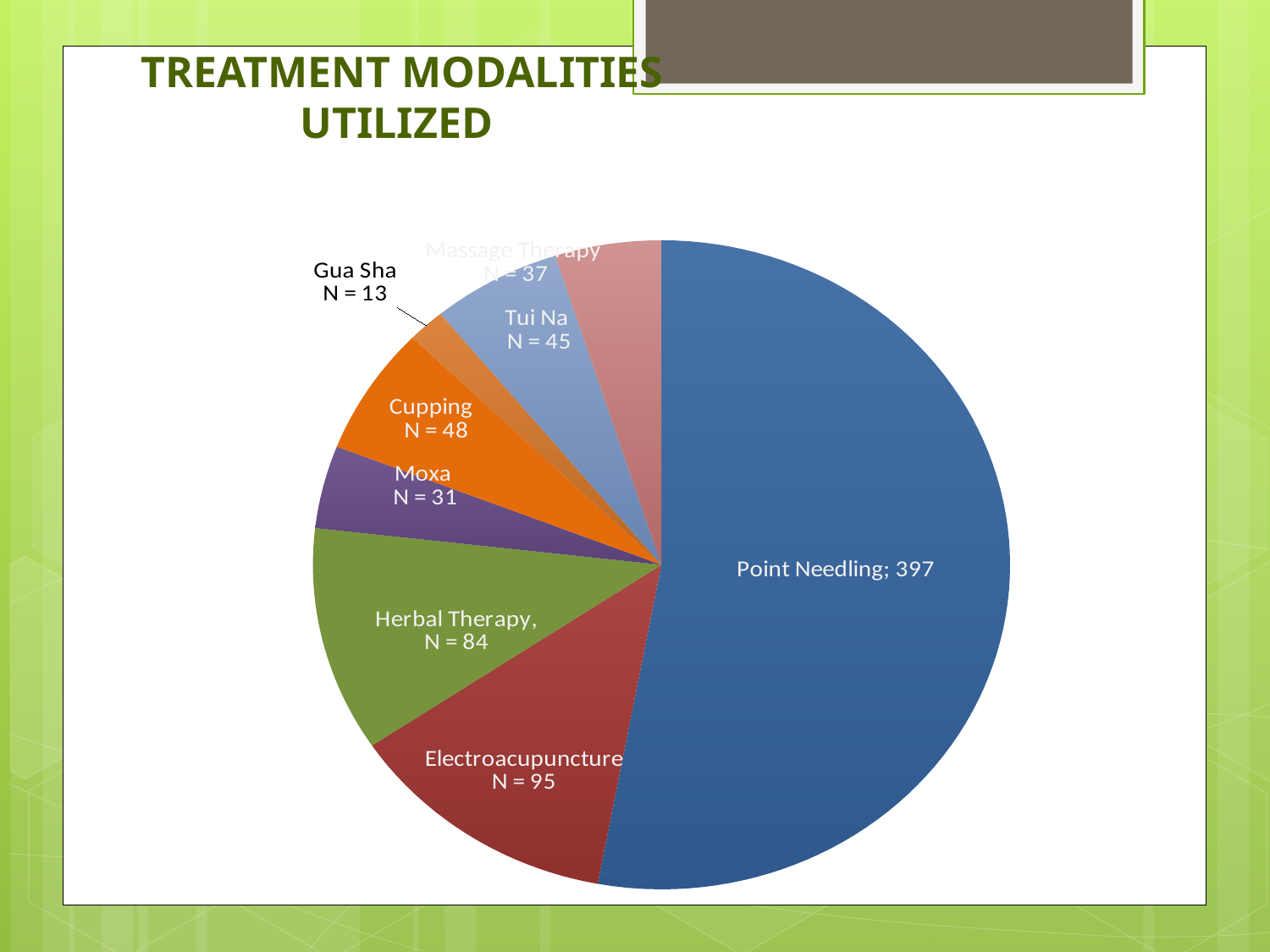
What is the N value for Cupping? 48 What type of chart is shown on the slide? pie chart What is the title of the chart? TREATMENT MODALITIES UTILIZED Which treatment modality has the largest slice? Point Needling What is the difference between the values for Electroacupuncture and Herbal Therapy? 11 Which is larger, the value for Tui Na or the value for Moxa? Tui Na What is the N value for Herbal Therapy? 84 What is the value for Point Needling? 397 What is the N value for Electroacupuncture? 95 What is the N value for Gua Sha? 13 Which treatment modality has the smallest slice? Gua Sha How many slices does the pie chart have? 8